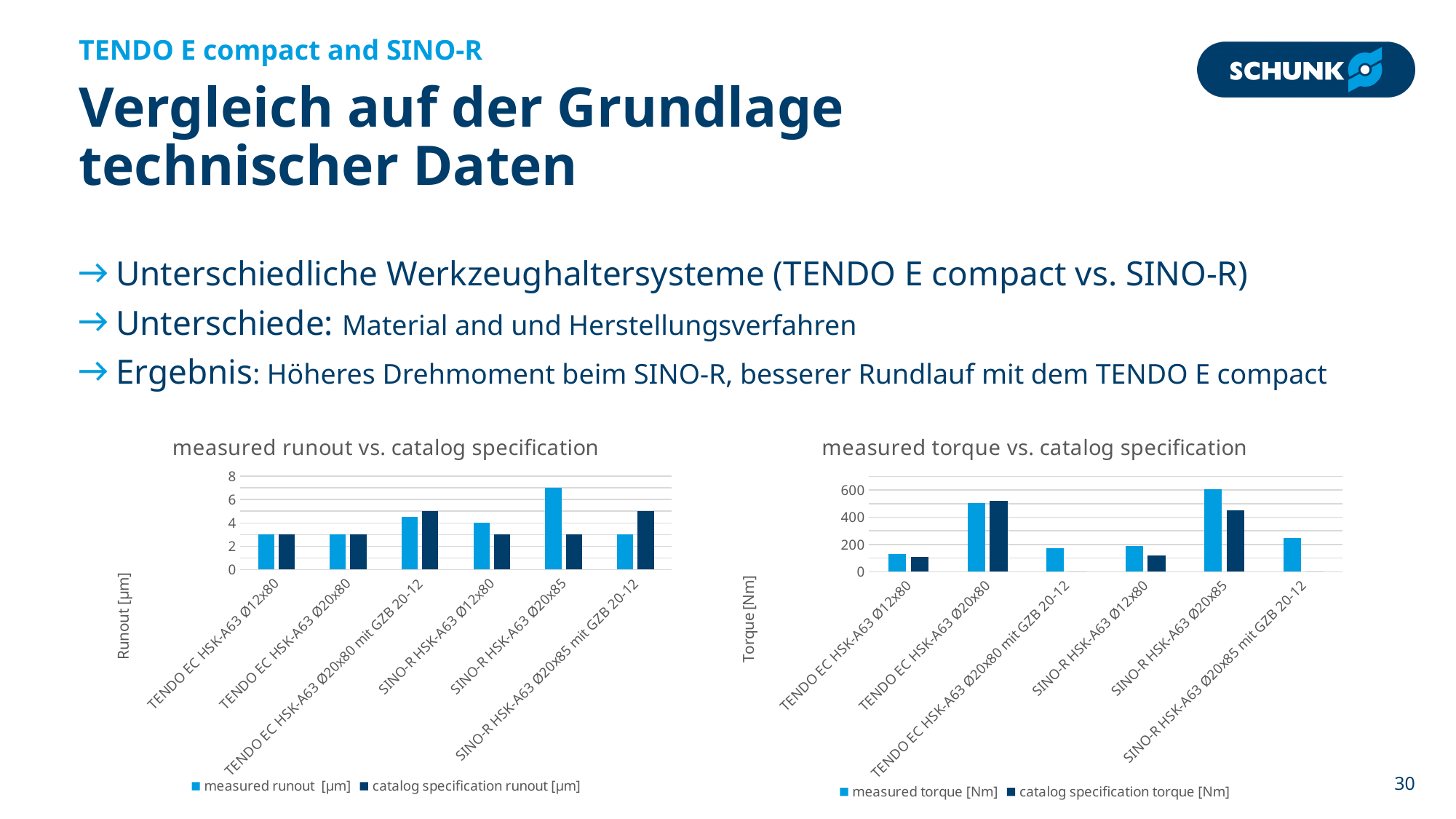
In the 'measured runout vs. catalog specification' chart, for SINO-R HSK-A63 Ø20x85, which is larger: the measured runout or the catalog specification runout? measured runout In the 'measured runout vs. catalog specification' chart, which category has the highest measured runout? SINO-R HSK-A63 Ø20x85 In the 'measured torque vs. catalog specification' chart, is the catalog specification torque for SINO-R HSK-A63 Ø20x85 greater or less than 400? greater In the 'measured runout vs. catalog specification' chart, is the measured runout for SINO-R HSK-A63 Ø20x85 greater or less than 6? greater In the 'measured torque vs. catalog specification' chart, for SINO-R HSK-A63 Ø20x85, which is larger: the measured torque or the catalog specification torque? measured torque How many series does the legend of the 'measured torque vs. catalog specification' chart list? 2 How many categories are shown on the x axis of the 'measured runout vs. catalog specification' chart? 6 What is the y-axis label of the 'measured torque vs. catalog specification' chart? Torque [Nm] What kind of chart is the 'measured runout vs. catalog specification' chart? bar chart In the 'measured torque vs. catalog specification' chart, is the measured torque for TENDO EC HSK-A63 Ø20x80 greater or less than 400? greater In the 'measured torque vs. catalog specification' chart, which category has the highest measured torque? SINO-R HSK-A63 Ø20x85